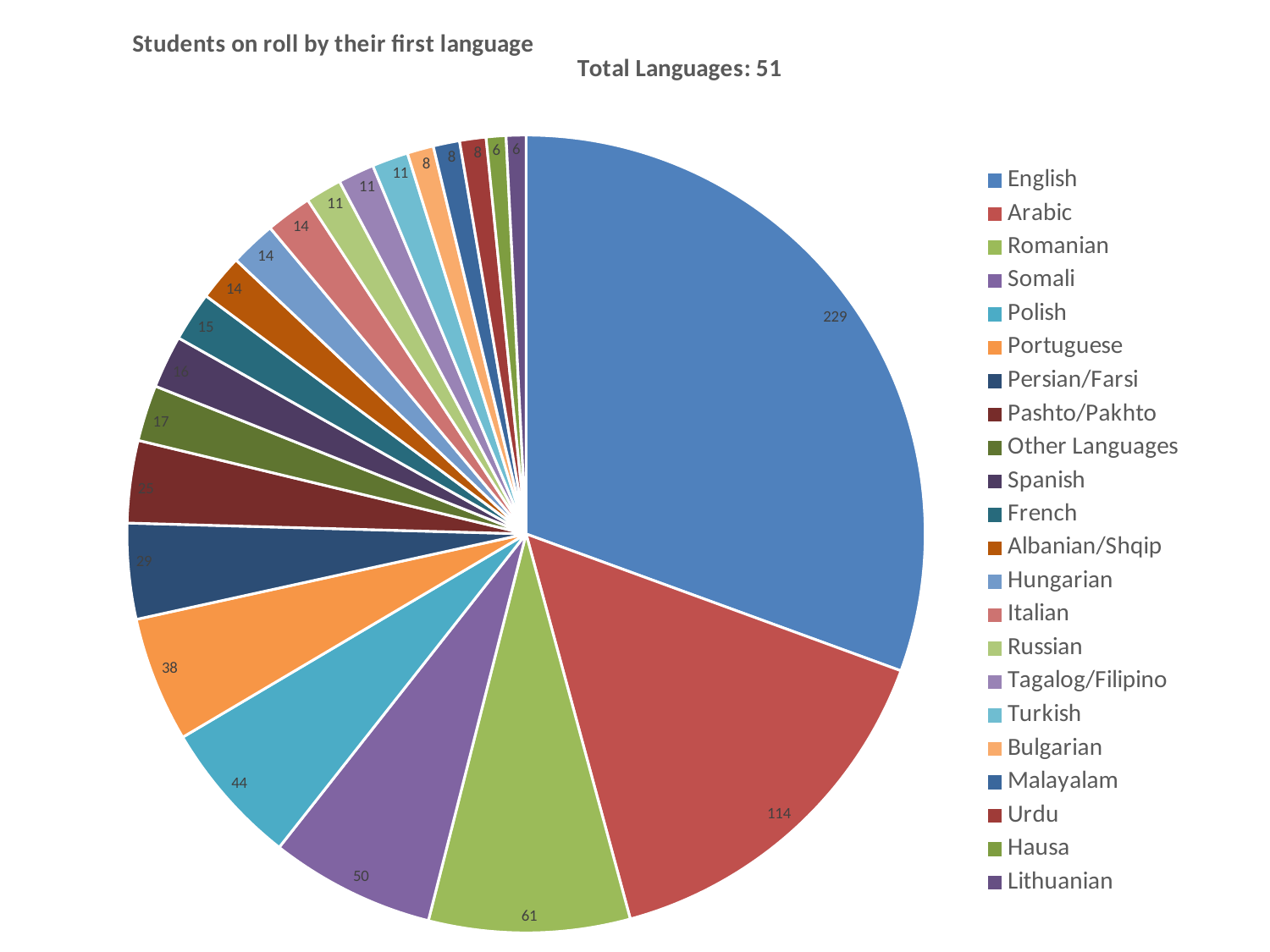
What is the difference between the English and Arabic values? 115 How many languages are listed in the legend? 22 How many students have Arabic as their first language? 114 What is the title of the chart? Students on roll by their first language What is the value shown for Polish? 44 Which is larger, the value for Portuguese or the value for Polish? Polish What is the value shown for Romanian? 61 How many students have English as their first language? 229 What is the value shown for Persian/Farsi? 29 What kind of chart is shown on the slide? pie chart What is the difference between the Romanian and Somali values? 11 Which first language has the largest slice of the pie? English